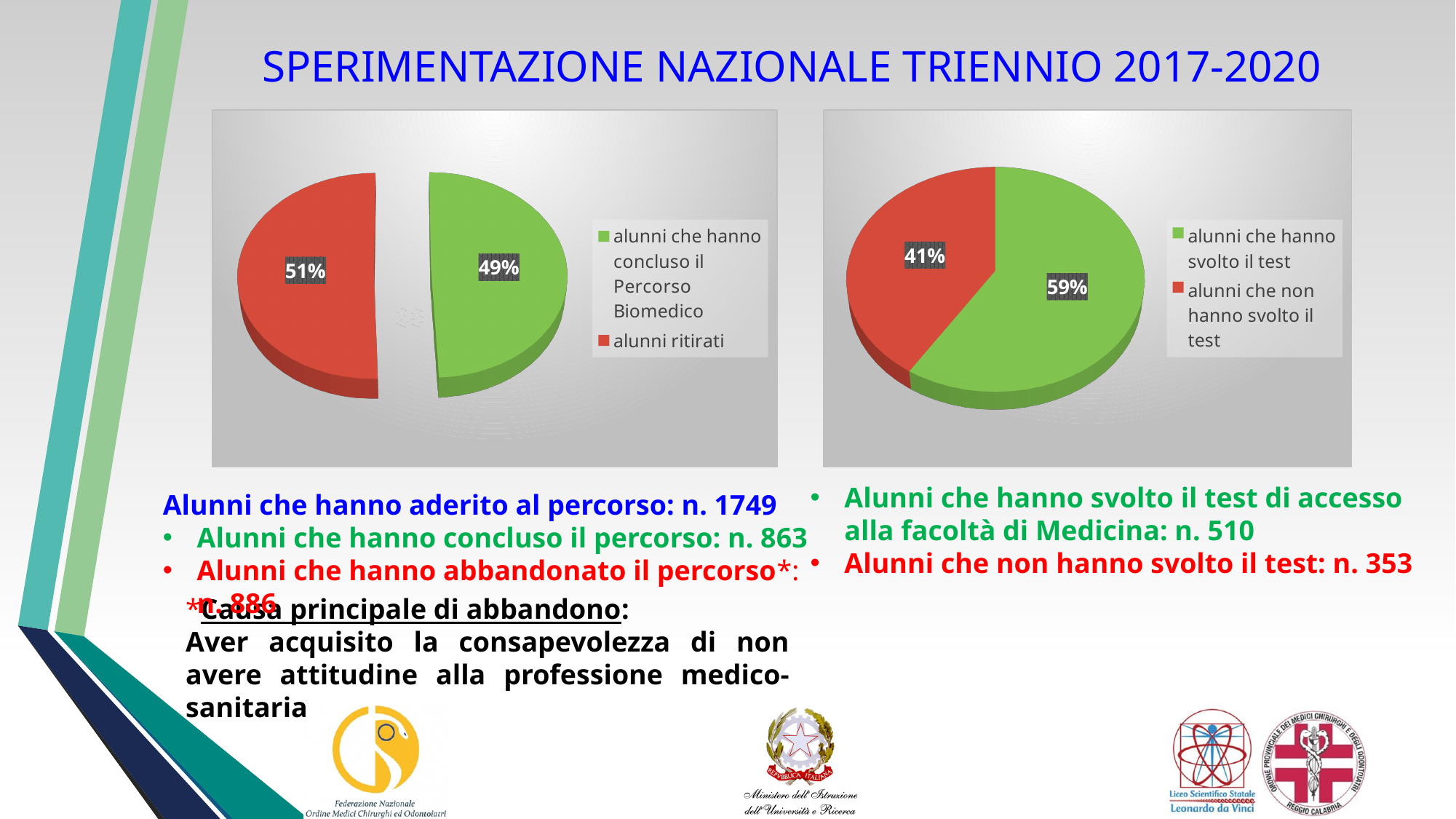
In the right pie chart, which category has the largest slice? alunni che hanno svolto il test How many categories does the legend of the right pie chart list? 2 In the right pie chart, what is the difference in percentage points between the two slices? 18 In the right pie chart, what share is shown for 'alunni che non hanno svolto il test'? 41% What type of chart is the left chart? pie chart In the left pie chart, what colour is the slice for 'alunni ritirati'? red In the right pie chart, which is larger: the share of students who took the test or the share who did not? alunni che hanno svolto il test In the right pie chart, what share is shown for 'alunni che hanno svolto il test'? 59% In the left pie chart, what share is shown for 'alunni ritirati'? 51% In the left pie chart, which category has the smallest slice? alunni che hanno concluso il Percorso Biomedico In the left pie chart, what share is shown for 'alunni che hanno concluso il Percorso Biomedico'? 49% In the left pie chart, what is the difference in percentage points between 'alunni ritirati' and 'alunni che hanno concluso il Percorso Biomedico'? 2